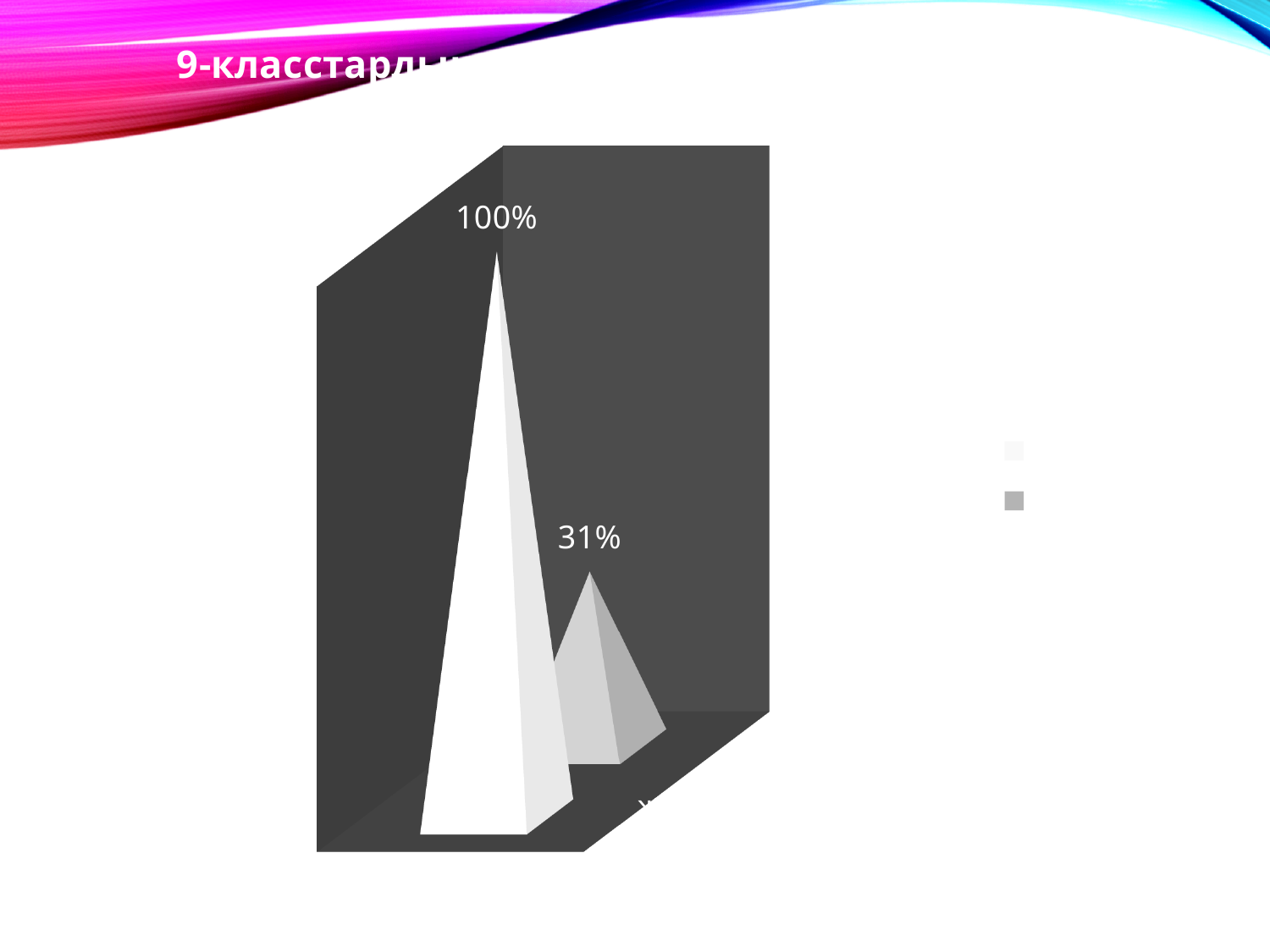
What is the highest value labelled in the chart? 100% What is the difference between the two labelled values in the chart, 100% and 31%? 69% Which bar has the larger value, the left one or the right one? the left one How many entries does the chart's legend show? 2 Is the value of the right bar greater or less than 50%? less What is the value shown on the data label of the shorter bar on the right of the chart? 31% What kind of chart is shown on the slide? bar chart What is the lowest value labelled in the chart? 31% What shape are the bars drawn as in the chart? pyramids How many data points are plotted in the chart? 2 Do the values fall or rise from the left bar to the right bar? fall What is the value shown on the data label of the tallest bar in the chart? 100%